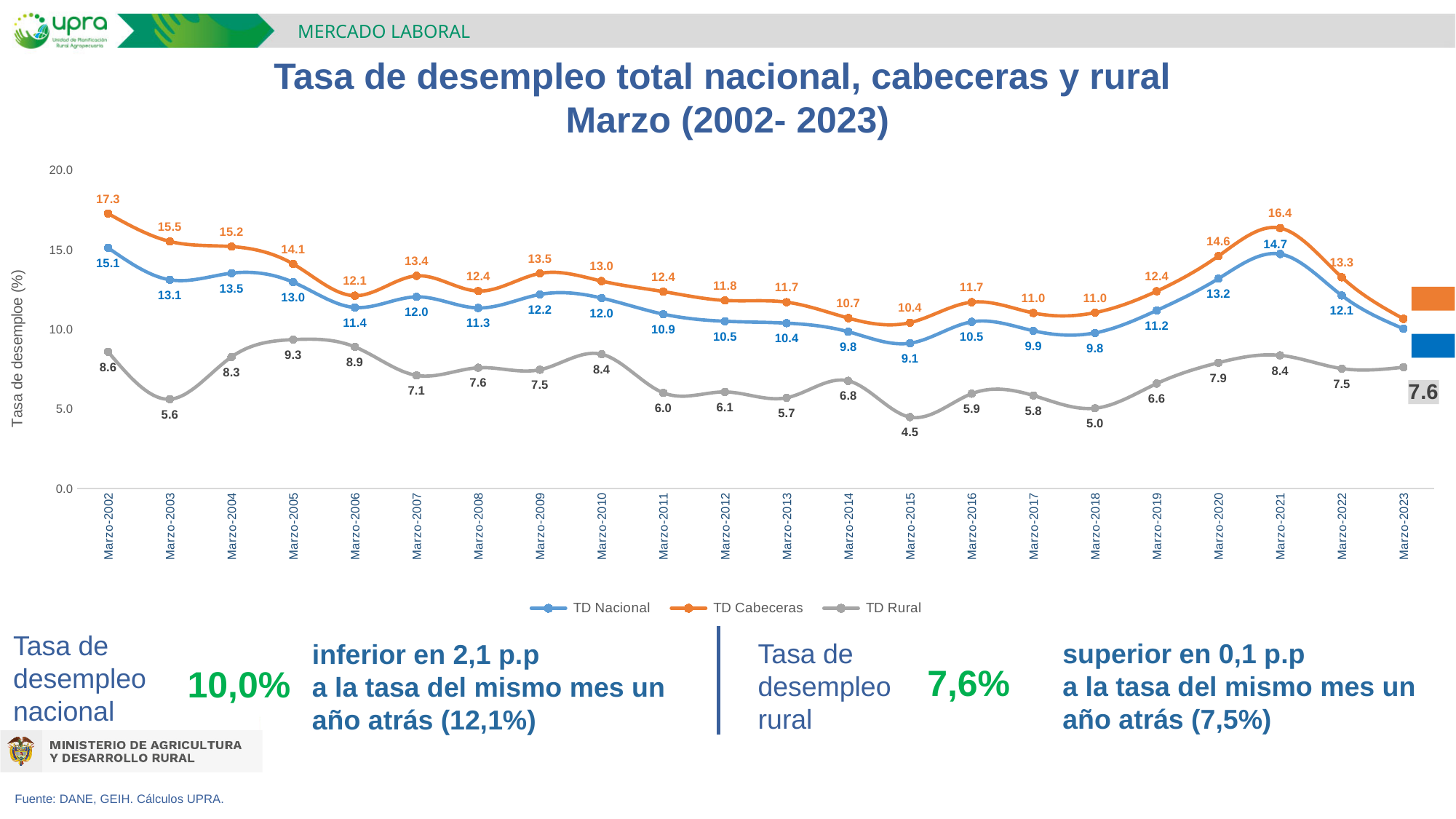
Which has a higher TD Rural value, Marzo-2005 or Marzo-2010? Marzo-2005 Is the value of TD Cabeceras for Marzo-2023 greater or less than 15.0? less What is the value of TD Nacional for Marzo-2015? 9.1 What is the value of TD Rural for Marzo-2015? 4.5 What is the value of TD Cabeceras for Marzo-2002? 17.3 How many series does the legend list? 3 How many periods are shown on the x axis? 22 In which period does TD Rural reach its lowest value? Marzo-2015 What kind of chart is shown on the slide? line chart What is the difference between the TD Nacional values for Marzo-2021 and Marzo-2022? 2.6 Does TD Nacional rise or fall from Marzo-2018 to Marzo-2021? rise In which period does TD Cabeceras reach its highest value? Marzo-2002